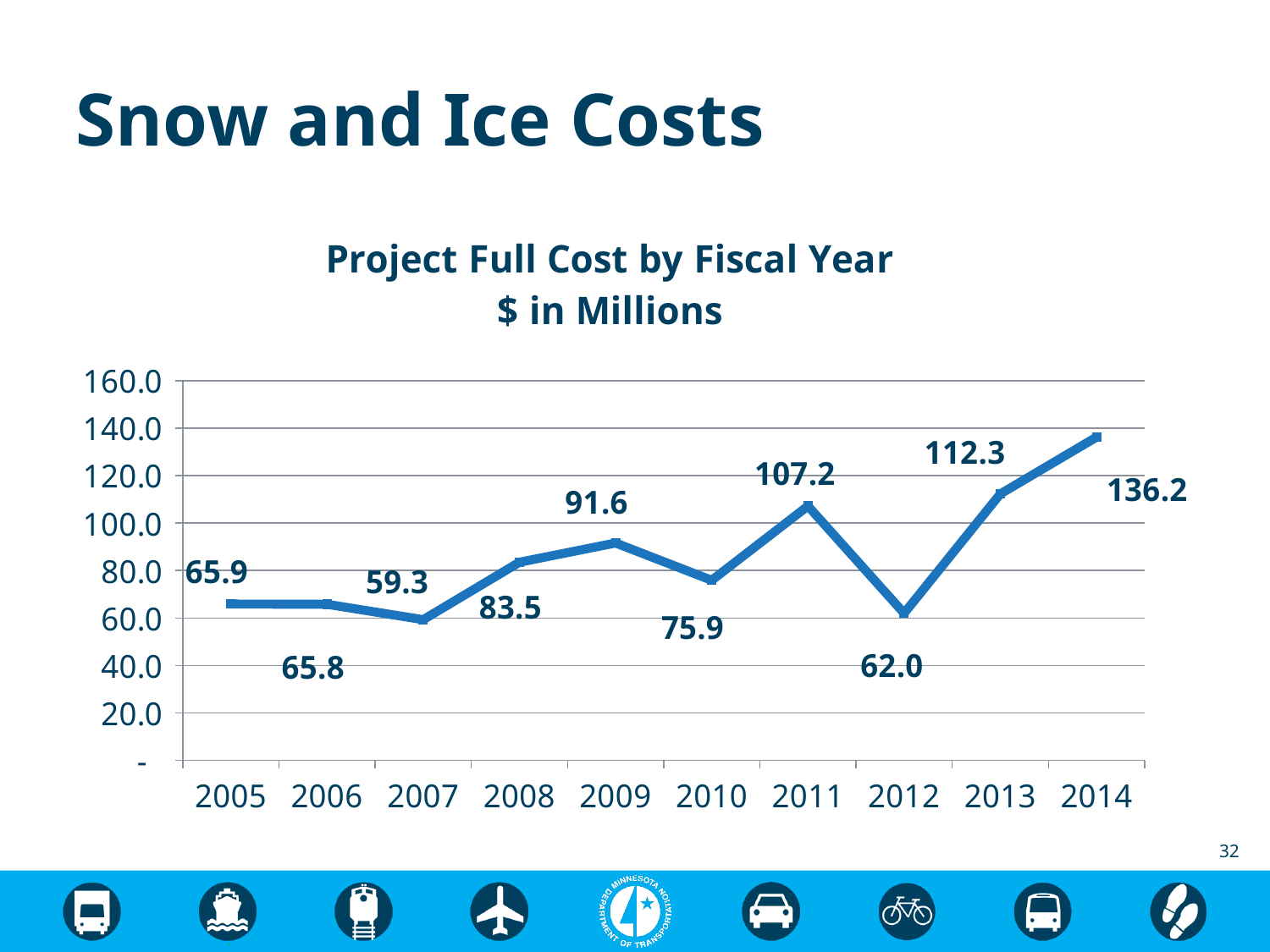
What is the difference between the project full cost in 2014 and in 2013? 23.9 What is the project full cost for fiscal year 2011? 107.2 What is the title of the chart? Project Full Cost by Fiscal Year $ in Millions Which fiscal year has the highest project full cost? 2014 What kind of chart is shown on the slide? Line chart How many fiscal years are plotted on the chart? 10 What is the project full cost for fiscal year 2007? 59.3 Which fiscal year has the lowest project full cost? 2007 Which fiscal year has a higher project full cost, 2009 or 2010? 2009 What is the difference between the project full cost in 2011 and in 2012? 45.2 What is the project full cost for fiscal year 2012? 62.0 Is the project full cost for 2013 greater or less than 100.0? greater